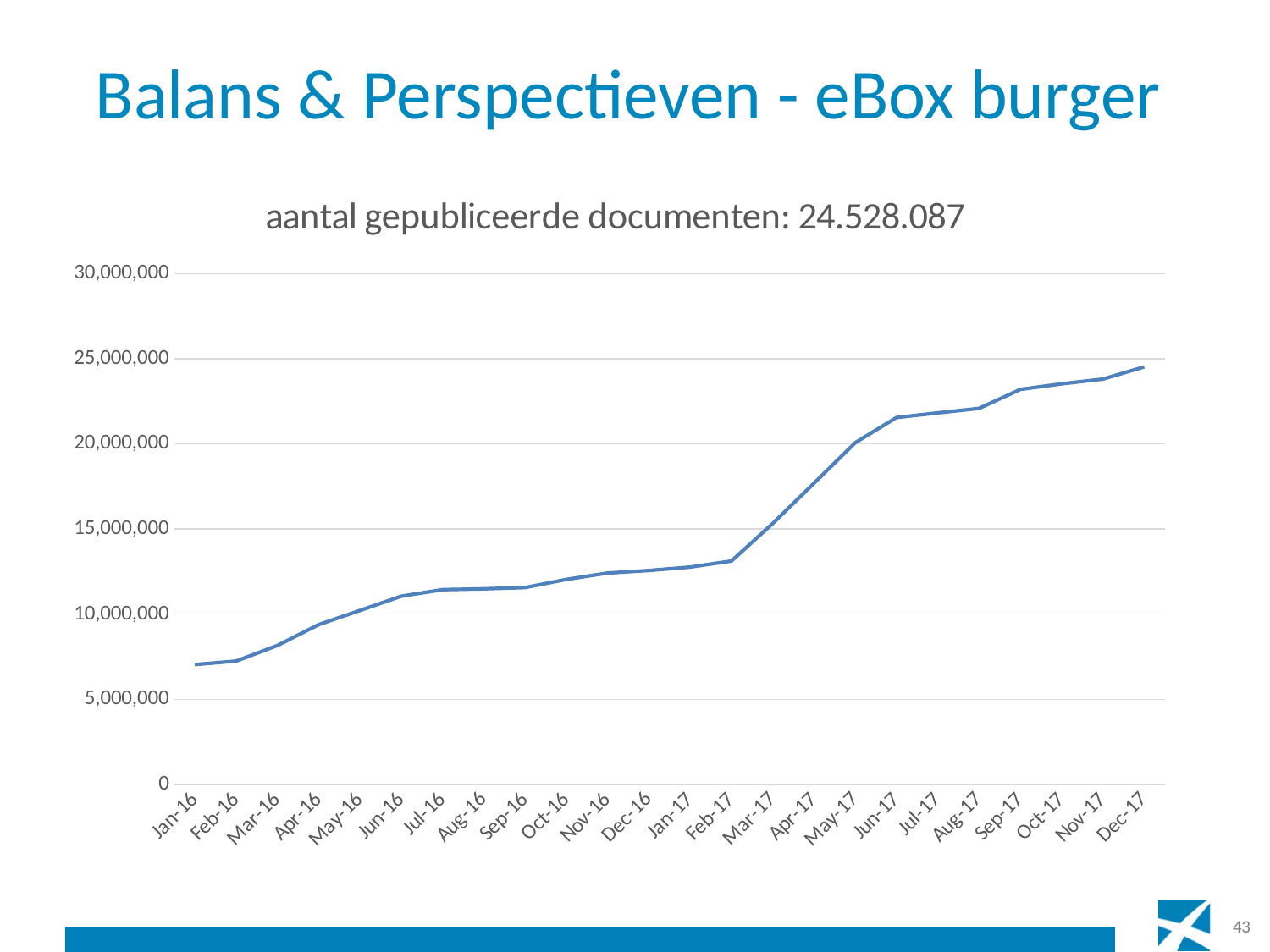
Which month has the lowest value? Jan-16 Which month has the highest value? Dec-17 What is the title of the chart? aantal gepubliceerde documenten: 24.528.087 Is the value for Feb-17 greater or less than 15,000,000? less Is the value for Jan-16 greater or less than 10,000,000? less Which is larger, the value for Jun-16 or the value for Jun-17? Jun-17 Is the value for Dec-17 greater or less than 20,000,000? greater Do the values rise or fall from Jan-16 to Dec-17? rise What is the highest value shown on the y axis? 30,000,000 How many monthly data points are plotted on the x axis? 24 What kind of chart is shown on the slide? line chart